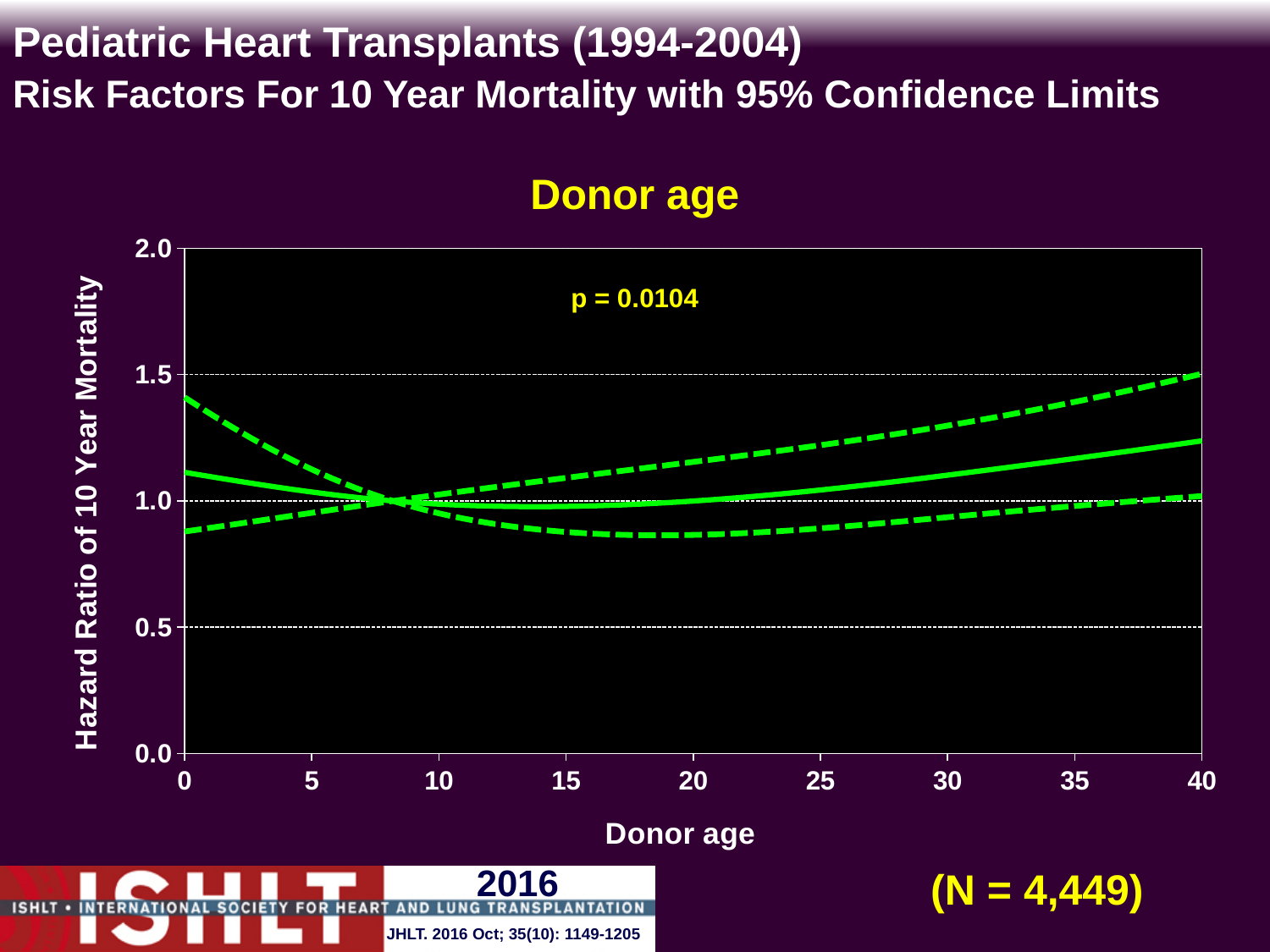
What p-value is printed on the chart? p = 0.0104 How many lines are plotted on the chart? 3 What is the title of the chart? Donor age Is the value of the upper dashed confidence limit at donor age 0 greater or less than 1.5? less What is the highest donor age shown on the x axis? 40 What sample size (N) is printed on the slide? N = 4,449 What kind of chart is shown on the slide? line chart What is the label of the y axis? Hazard Ratio of 10 Year Mortality Does the solid hazard ratio line rise or fall between donor age 20 and donor age 40? rise Is the value of the lower dashed confidence limit at donor age 20 greater or less than 1.0? less Is the value of the solid hazard ratio line at donor age 40 greater or less than 1.0? greater What is the highest value shown on the y axis? 2.0